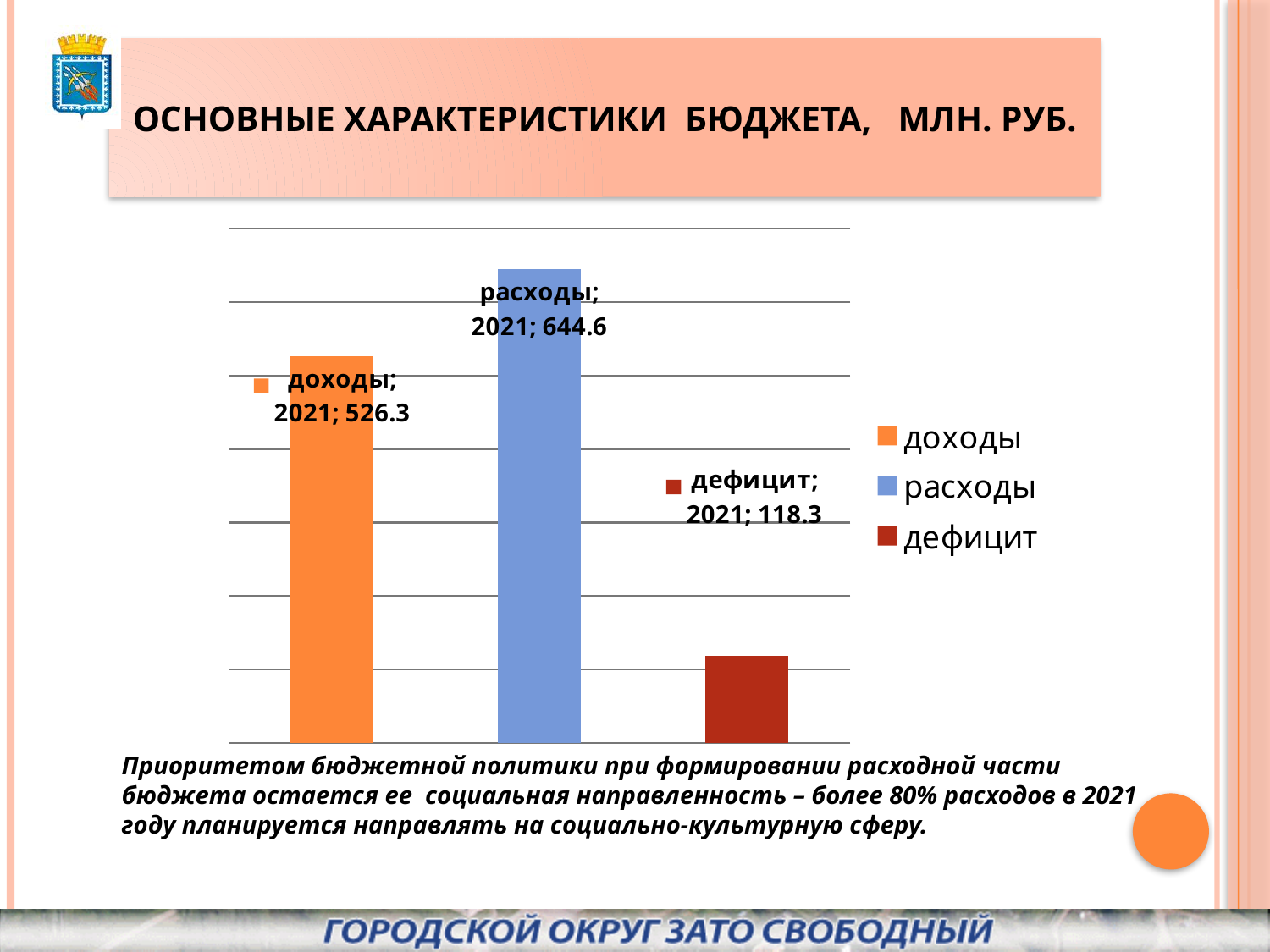
What kind of chart is shown on the slide? bar chart What is the value for расходы in 2021? 644.6 What is the value for доходы in 2021? 526.3 Which series has the lowest value? дефицит Which series has the highest value? расходы How many series does the legend list? 3 What is the difference between расходы and доходы in 2021? 118.3 What is the value for дефицит in 2021? 118.3 What colour is the bar for дефицит? dark red Which is larger, доходы or расходы? расходы What is the difference between доходы and дефицит in 2021? 408.0 How many bars are plotted on the chart? 3